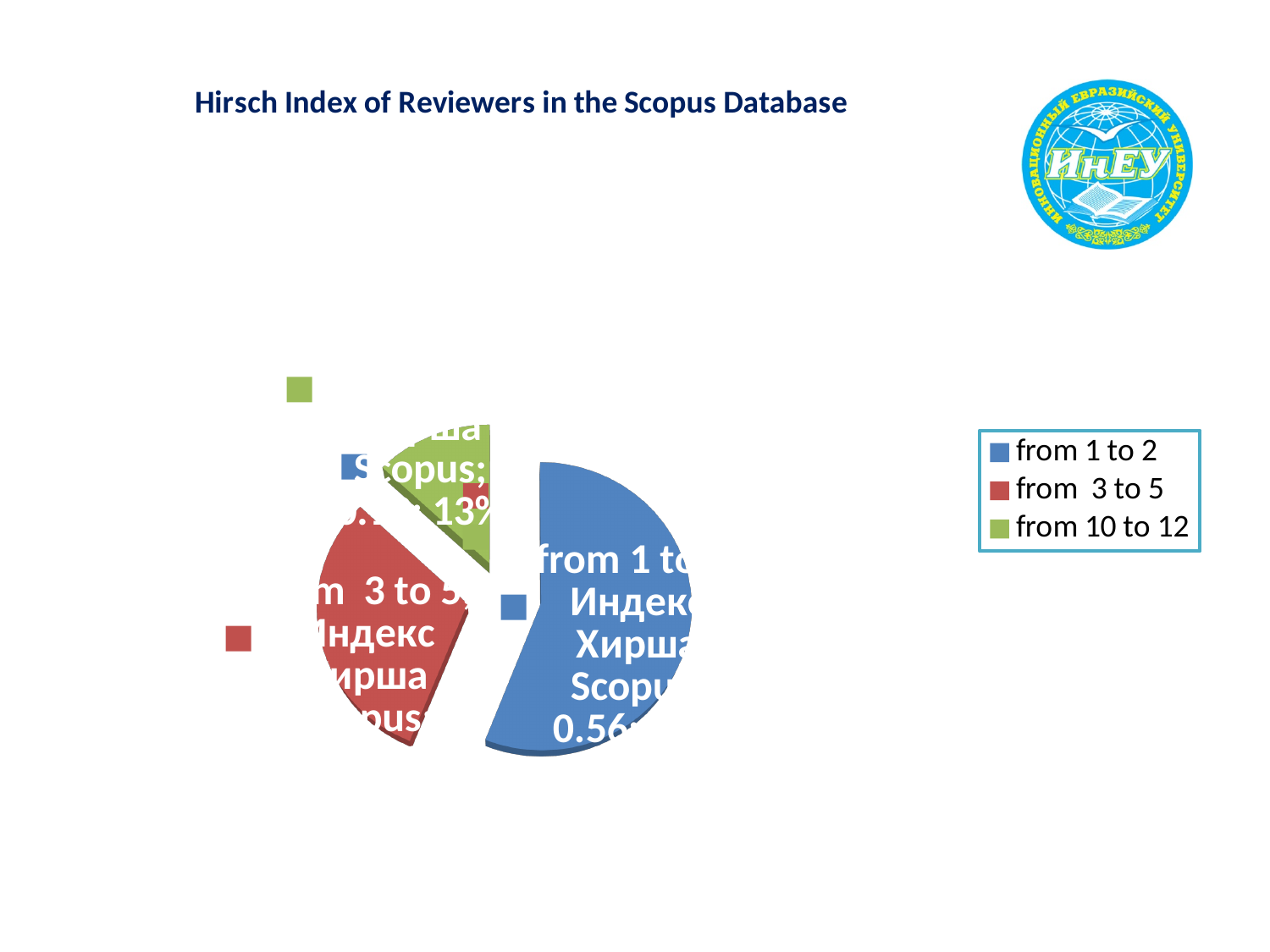
How many entries does the legend of the pie chart list? 3 What colour is the 'from 10 to 12' slice in the pie chart? green Which category has the smallest slice of the pie chart? from 10 to 12 What kind of chart is shown on the slide? pie chart Which slice is larger: 'from 1 to 2' or 'from 3 to 5'? from 1 to 2 Which category has the largest slice of the pie chart? from 1 to 2 Which category is shown in red in the pie chart? from 3 to 5 Which slice is larger: 'from 3 to 5' or 'from 10 to 12'? from 3 to 5 What is the title of the chart on the slide? Hirsch Index of Reviewers in the Scopus Database How many slices does the pie chart have? 3